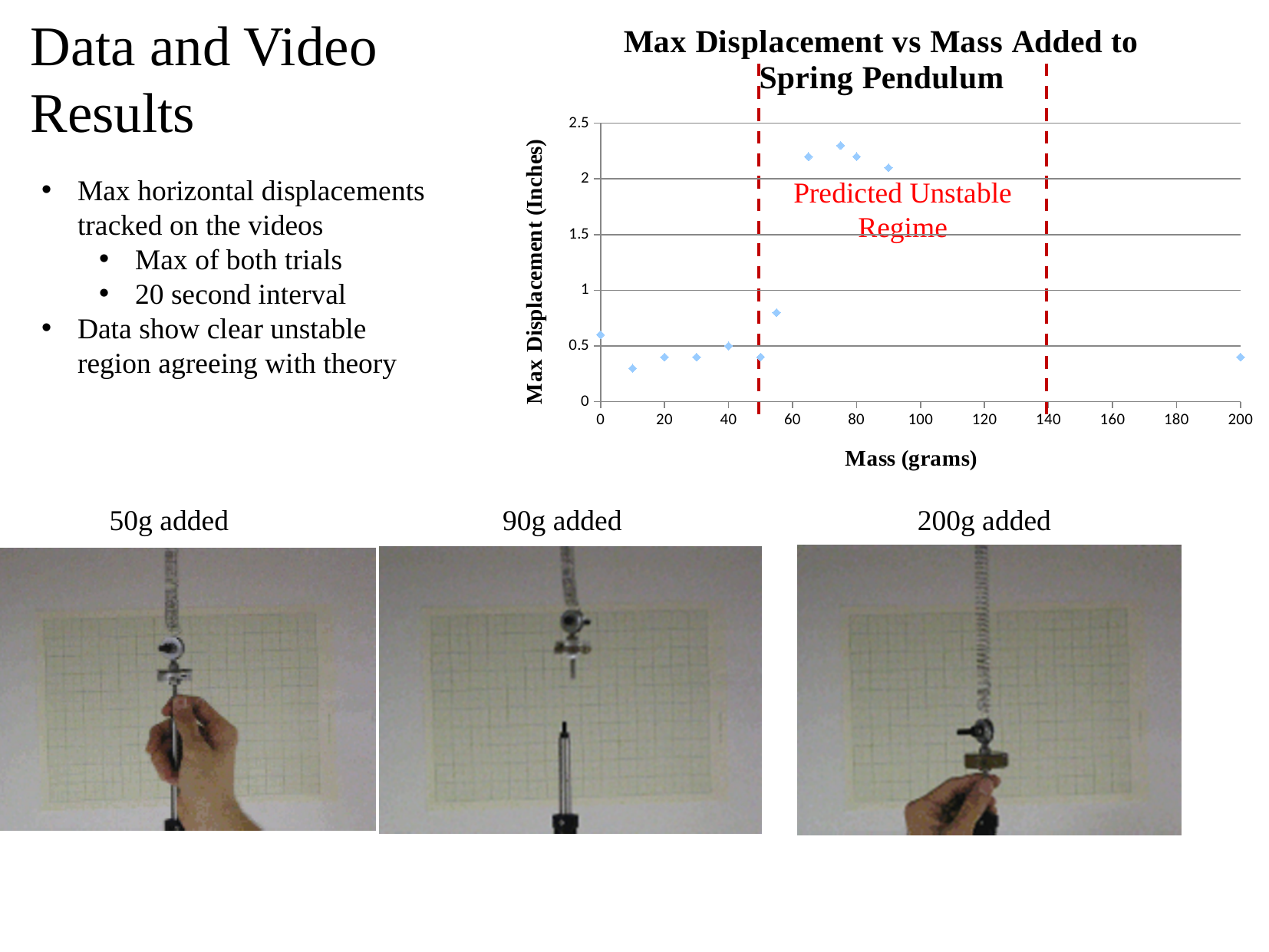
What is the title of the chart? Max Displacement vs Mass Added to Spring Pendulum Is the max displacement at 55 grams greater or less than 1 inch? less How many data points are plotted on the chart? 12 Is the max displacement at 75 grams greater or less than 2 inches? greater What kind of chart is shown on the slide? Scatter chart Is the max displacement at 10 grams greater or less than 0.5 inches? less Do the max displacement values rise or fall as mass increases from 50 grams to 75 grams? rise What label is written in red between the two dashed vertical lines on the chart? Predicted Unstable Regime